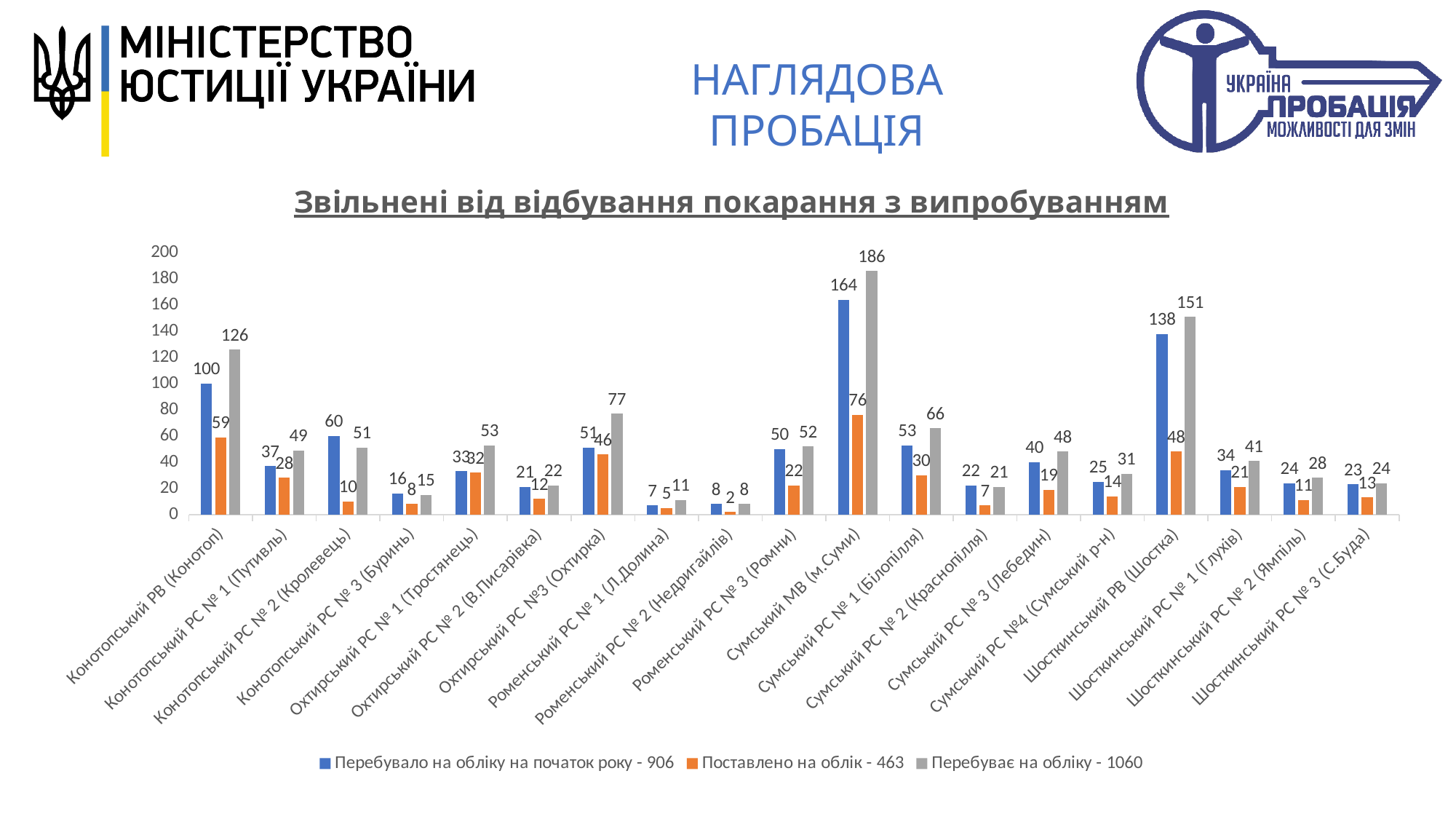
Which category has the highest value for 'Перебуває на обліку'? Сумський МВ (м.Суми) What is the value of 'Перебуває на обліку' for Сумський МВ (м.Суми)? 186 Which is larger for Конотопський РС № 2 (Кролевець): 'Перебувало на обліку на початок року' or 'Перебуває на обліку'? Перебувало на обліку на початок року Which category has the lowest value for 'Поставлено на облік'? Роменський РС № 2 (Недригайлів) What type of chart is shown on the slide? Bar chart What total is shown in the legend for the series 'Перебуває на обліку'? 1060 Is the value of 'Перебуває на обліку' for Шосткинський РВ (Шостка) greater or less than 140? greater What is the value of 'Поставлено на облік' for Конотопський РВ (Конотоп)? 59 What is the difference between 'Перебуває на обліку' and 'Перебувало на обліку на початок року' for Охтирський РС №3 (Охтирка)? 26 How many series does the legend list? 3 What is the value of 'Перебувало на обліку на початок року' for Шосткинський РВ (Шостка)? 138 How many categories (units) are shown on the x axis? 19